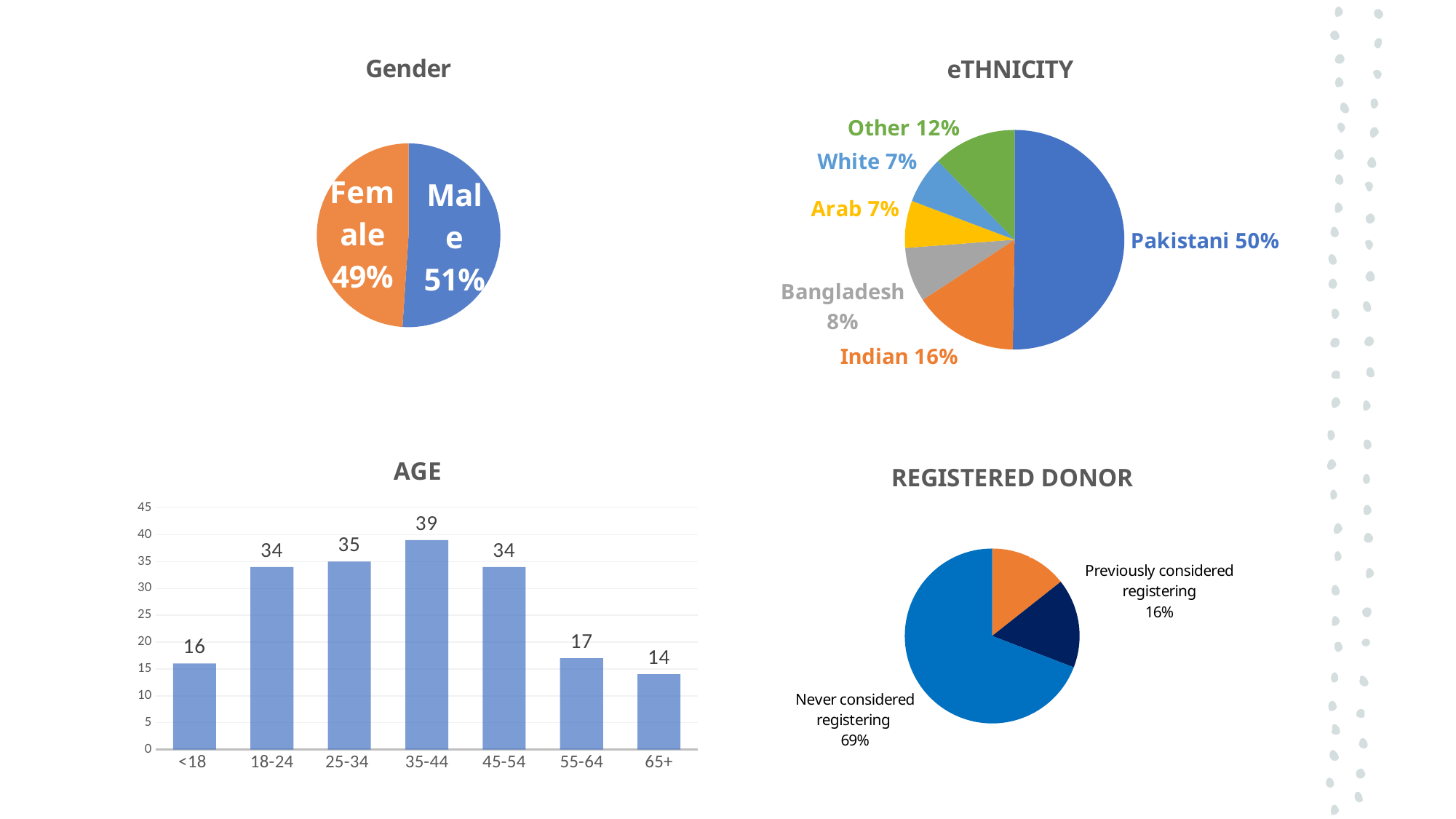
In the AGE chart, how many categories are shown on the x axis? 7 In the eTHNICITY chart, how many slices does the pie have? 6 In the eTHNICITY chart, which category has the largest slice? Pakistani In the AGE chart, which category has the lowest value? 65+ In the Gender chart, what share of the pie is Female? 49% In the eTHNICITY chart, what share of the pie is Pakistani? 50% In the REGISTERED DONOR chart, what share of the pie is Never considered registering? 69% What kind of chart is the AGE chart? Bar chart In the eTHNICITY chart, what is the difference between the Indian and Bangladesh shares? 8% In the AGE chart, what is the difference between the 35-44 and <18 values? 23 In the AGE chart, what is the value for the 35-44 category? 39